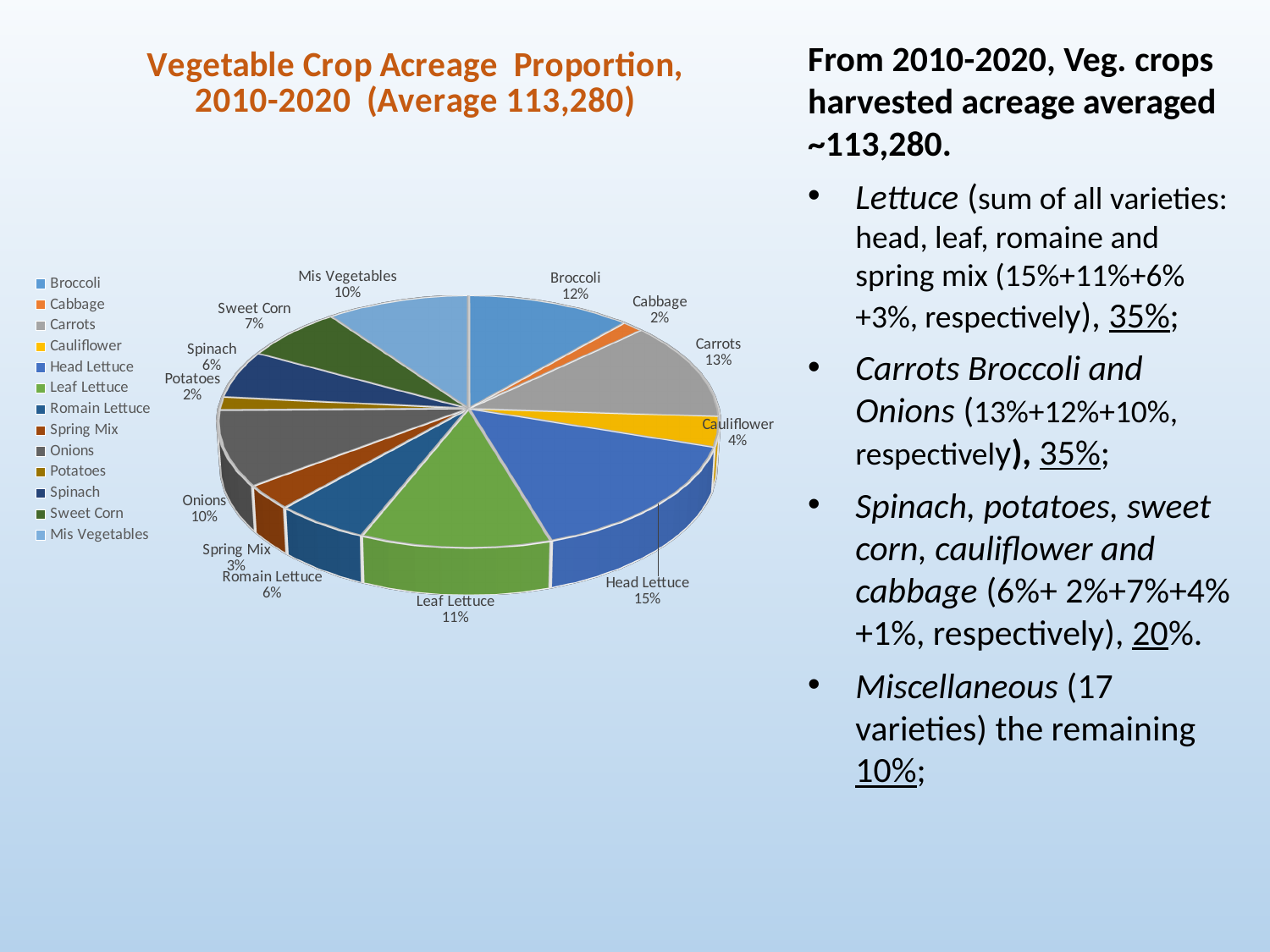
What is the difference in percentage points between Head Lettuce and Leaf Lettuce? 4 percentage points What type of chart is shown on the slide? Pie chart What share of the pie is Mis Vegetables? 10% What is the value shown for Carrots? 13% What is the value shown for Sweet Corn? 7% What percentage of the pie does Head Lettuce account for? 15% Which is larger, the slice for Carrots or the slice for Broccoli? Carrots What is the difference in percentage points between Onions and Spring Mix? 7 percentage points What is the title of the chart? Vegetable Crop Acreage Proportion, 2010-2020 (Average 113,280) How many categories are shown in the pie chart? 13 Which category has the largest slice of the pie? Head Lettuce Which is larger, the slice for Sweet Corn or the slice for Spinach? Sweet Corn